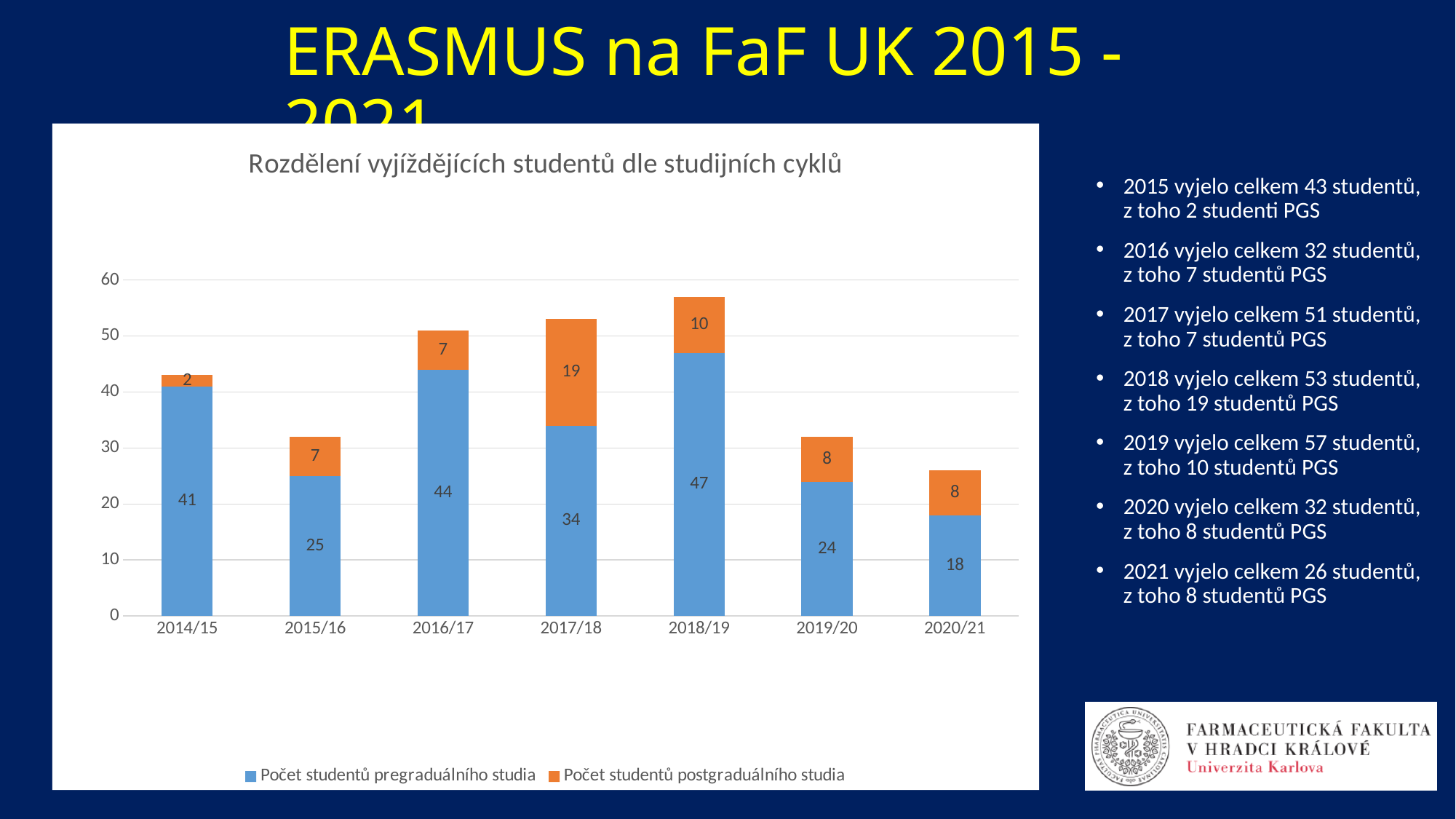
What is the total number of students (both series) for 2017/18? 53 What is the number of pregraduate students (Počet studentů pregraduálního studia) for 2018/19? 47 How many series does the legend list? 2 What type of chart is shown? Stacked bar chart What is the number of pregraduate students for 2020/21? 18 Is the total stacked bar for 2018/19 greater or less than 50? greater Which is larger: the number of postgraduate students in 2018/19 or in 2019/20? 2018/19 What is the difference between the pregraduate students in 2016/17 and 2015/16? 19 Which academic year has the lowest number of postgraduate students? 2014/15 Which academic year has the highest number of pregraduate students? 2018/19 What is the number of postgraduate students (Počet studentů postgraduálního studia) for 2017/18? 19 How many academic years are shown on the x axis? 7